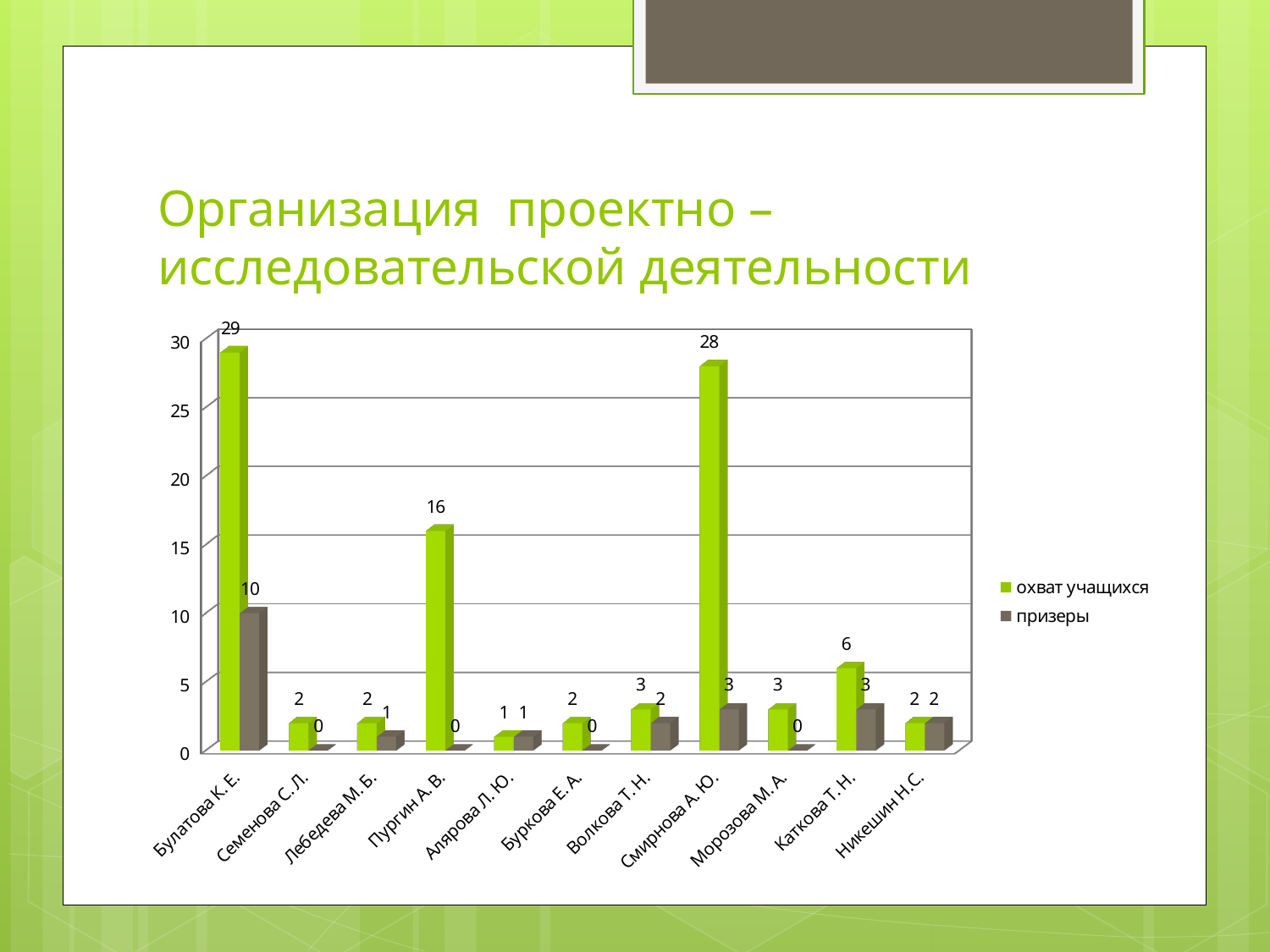
How many series does the legend list? 2 What kind of chart is shown on the slide? Bar chart Which series is shown in green in the legend? охват учащихся How many categories are shown on the x axis? 11 What is the value of "охват учащихся" for Булатова К.Е.? 29 What is the difference between "охват учащихся" and "призеры" for Булатова К.Е.? 19 Which category has the highest value for "охват учащихся"? Булатова К.Е. What is the value of "призеры" for Смирнова А.Ю.? 3 Which is larger: "охват учащихся" for Каткова Т.Н. or for Волкова Т.Н.? Каткова Т.Н. What is the value of "охват учащихся" for Пургин А.В.? 16 Which category has the highest value for "призеры"? Булатова К.Е. What is the value of "призеры" for Никешин Н.С.? 2